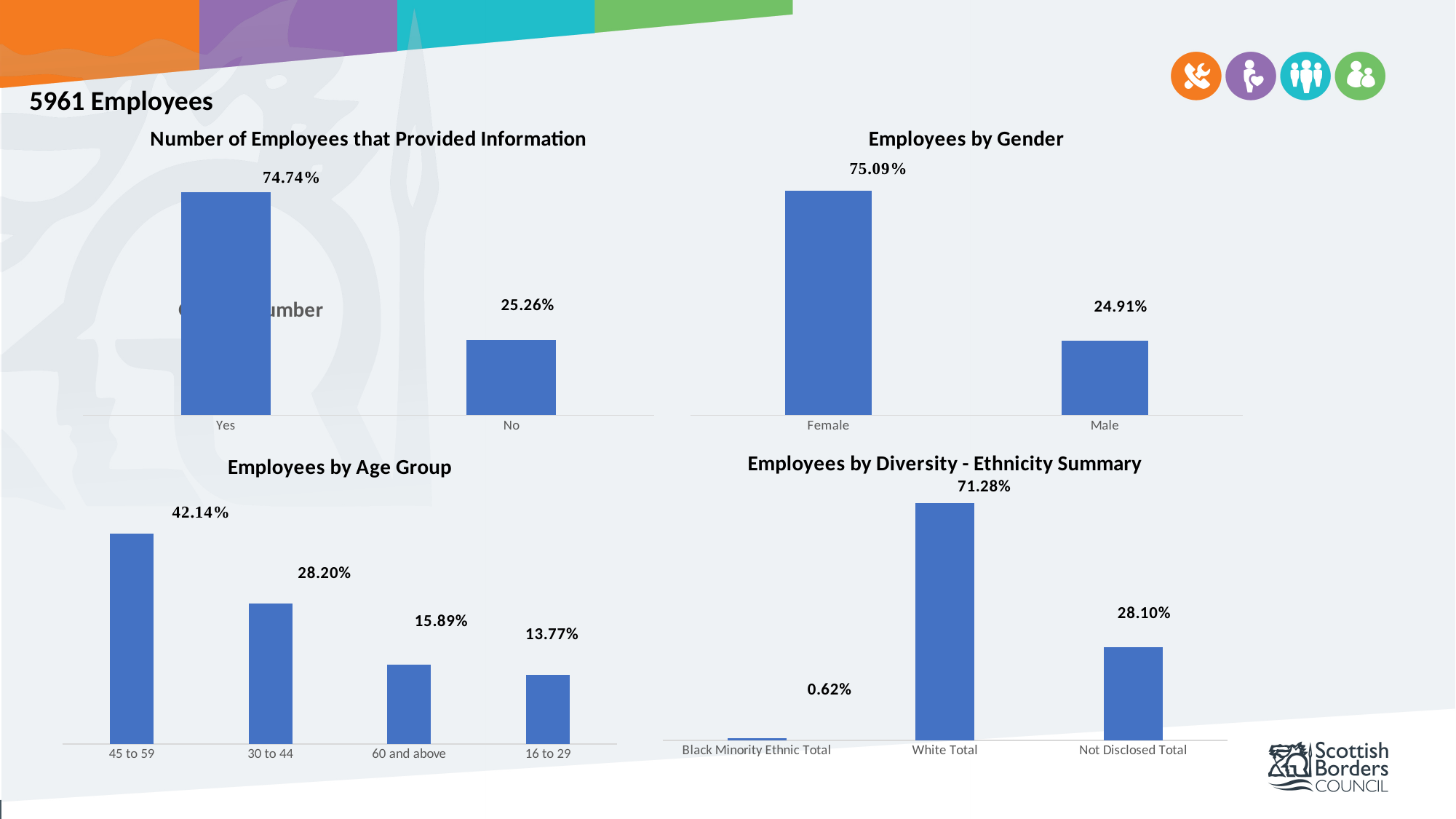
What type of chart is 'Employees by Gender'? Bar chart How many categories are shown in the 'Employees by Diversity - Ethnicity Summary' chart? 3 In the 'Employees by Age Group' chart, which age group has the lowest value? 16 to 29 In the 'Employees by Age Group' chart, which age group has the highest value? 45 to 59 In the 'Employees by Age Group' chart, what is the value for 60 and above? 15.89% In the 'Employees by Diversity - Ethnicity Summary' chart, what is the difference between White Total and Not Disclosed Total? 43.18% In the 'Employees by Diversity - Ethnicity Summary' chart, what is the value for Black Minority Ethnic Total? 0.62% How many categories are shown in the 'Employees by Age Group' chart? 4 In the 'Employees by Gender' chart, what is the difference between Female and Male? 50.18% In the 'Employees by Age Group' chart, which is larger, 30 to 44 or 60 and above? 30 to 44 In the 'Number of Employees that Provided Information' chart, what is the value for Yes? 74.74% In the 'Employees by Gender' chart, what is the value for Male? 24.91%